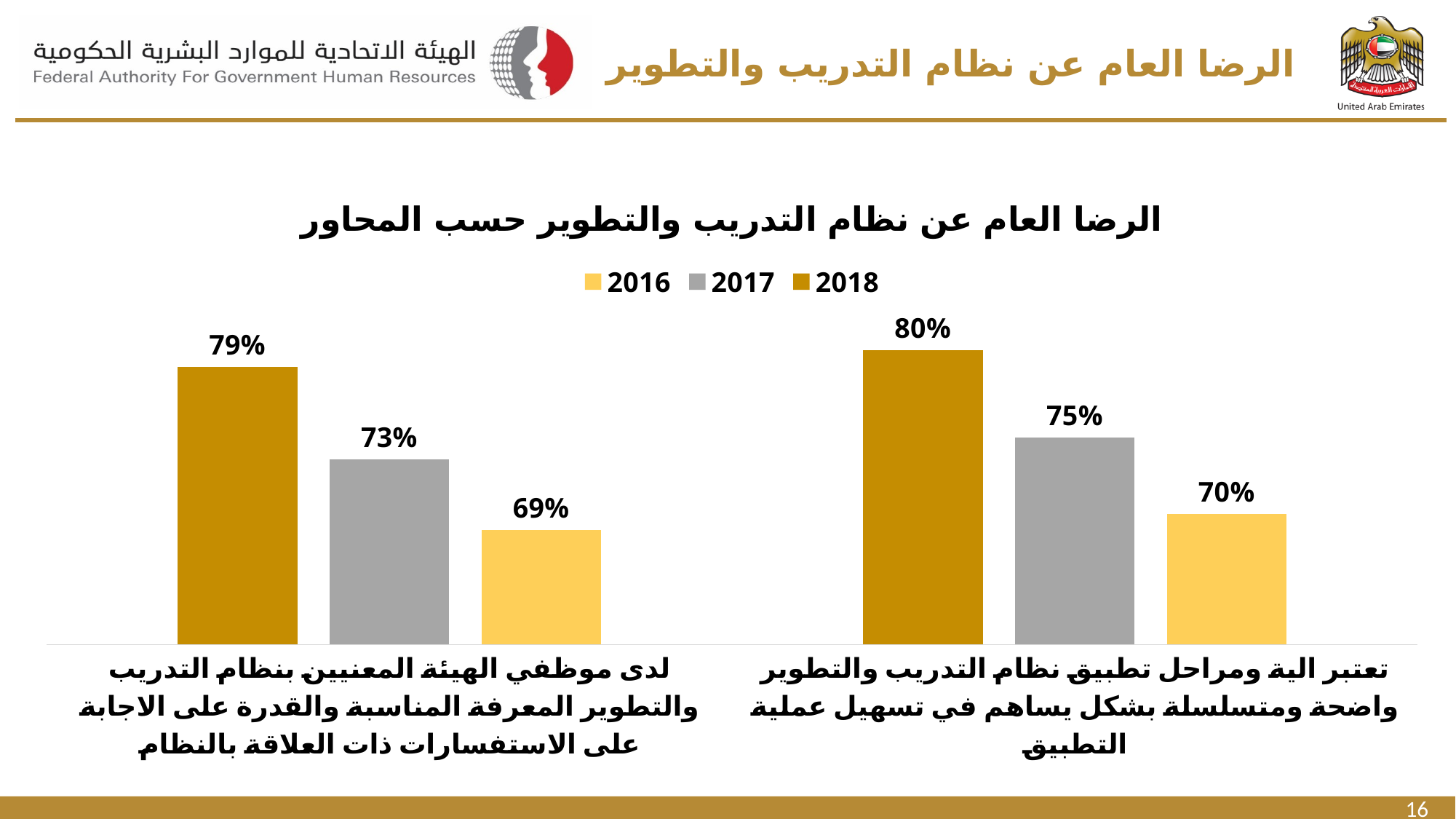
How many series does the legend list? 3 How many categories are shown on the x axis? 2 What is the 2018 value for the right-hand category (تعتبر الية ومراحل تطبيق نظام التدريب والتطوير واضحة ومتسلسلة)? 80% What is the 2016 value for the left-hand category (لدى موظفي الهيئة المعنيين بنظام التدريب والتطوير المعرفة المناسبة)? 69% What type of chart is shown on the slide? bar chart Do the values for the right-hand category rise or fall from 2016 to 2018? rise Which year has the lowest value for the right-hand category (تعتبر الية ومراحل تطبيق نظام التدريب والتطوير واضحة ومتسلسلة)? 2016 What is the title of the chart? الرضا العام عن نظام التدريب والتطوير حسب المحاور Which year has the highest value for the left-hand category (لدى موظفي الهيئة المعنيين بنظام التدريب والتطوير المعرفة المناسبة)? 2018 What is the difference between the 2018 and 2016 values for the left-hand category (لدى موظفي الهيئة المعنيين بنظام التدريب والتطوير المعرفة المناسبة)? 10% What is the 2017 value for the right-hand category (تعتبر الية ومراحل تطبيق نظام التدريب والتطوير واضحة ومتسلسلة)? 75% Which is larger: the 2017 value for the right-hand category or the 2017 value for the left-hand category? the right-hand category (75%)